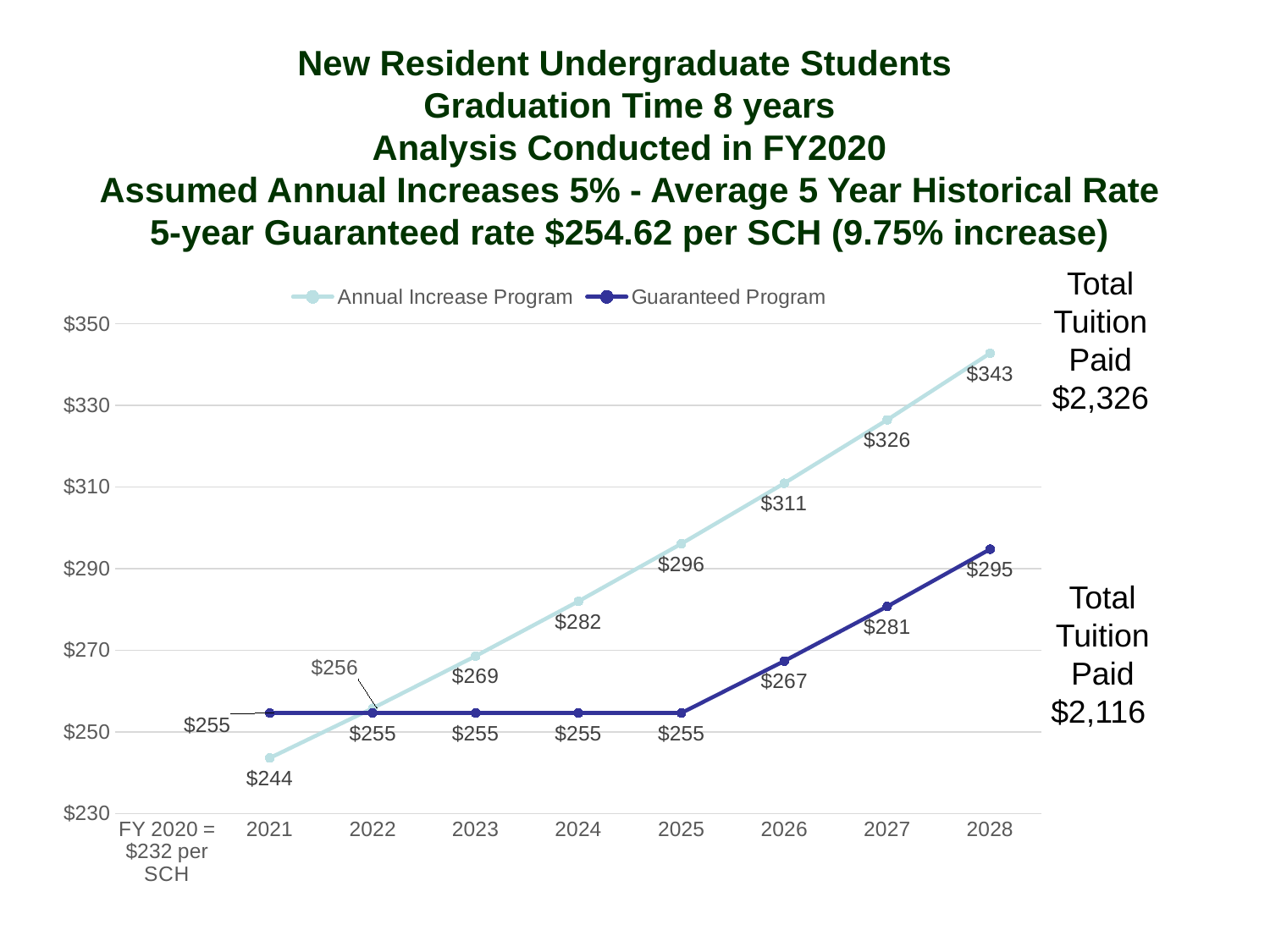
Does the Annual Increase Program rise or fall from 2021 to 2028? Rise How many series does the legend list? 2 What is the value of the Annual Increase Program in 2021? $244 In which year does the Annual Increase Program reach its highest value? 2028 What is the value of the Guaranteed Program in 2026? $267 Is the value of the Annual Increase Program in 2026 greater or less than $310? greater What is the difference between the Annual Increase Program and the Guaranteed Program in 2028? $48 Which series has the higher value in 2025, Annual Increase Program or Guaranteed Program? Annual Increase Program In which year is the Annual Increase Program at its lowest value? 2021 How many years are shown on the x axis of the chart? 8 What is the value of the Annual Increase Program in 2028? $343 What kind of chart is shown on the slide? Line chart